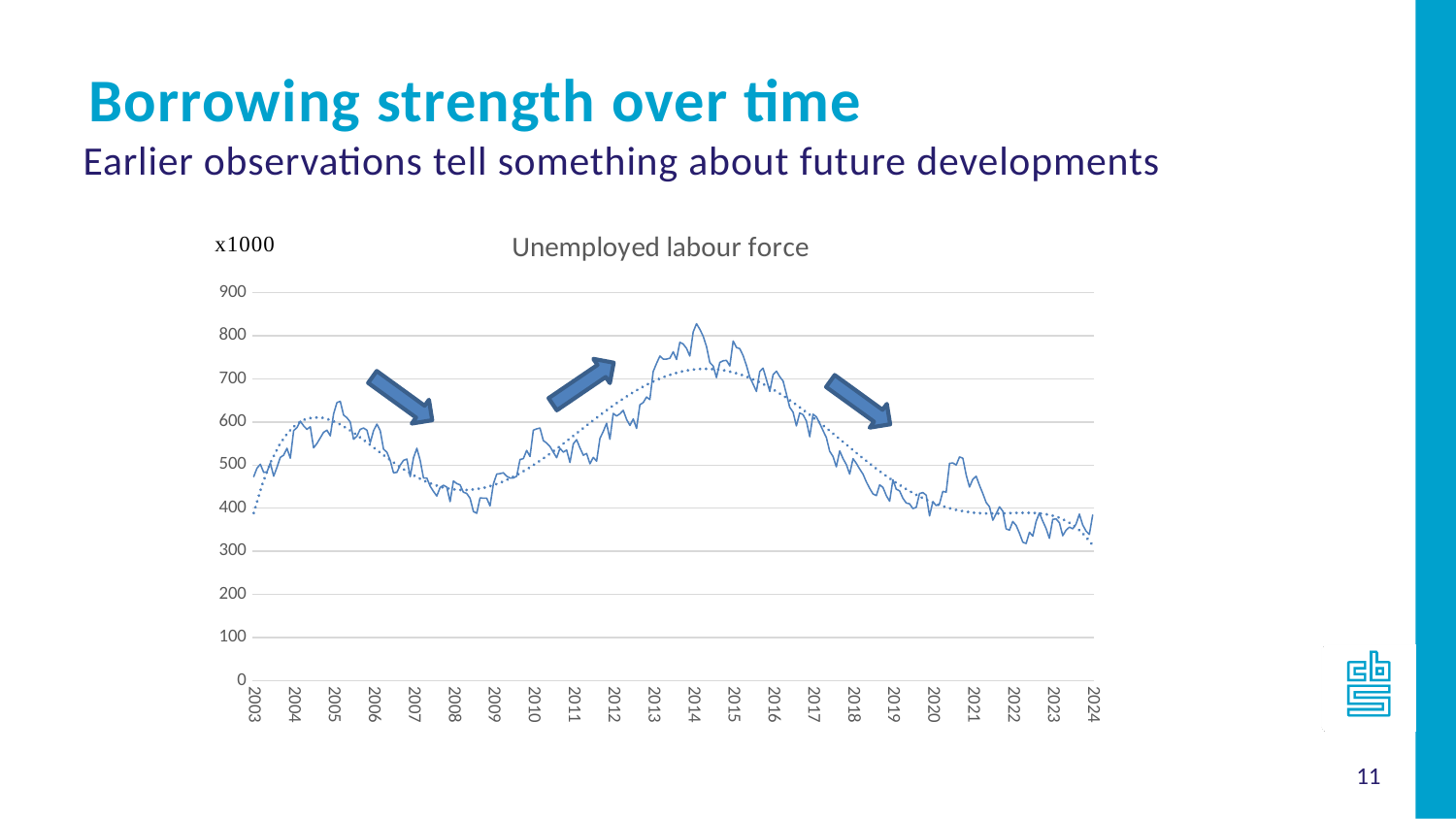
Is the peak value of the line around 2014 greater or less than 700? greater Is the value of the line at the start of 2017 greater or less than 500? greater What is the title of the chart? Unemployed labour force Does the line rise or fall between 2014 and 2022? fall How many year labels are shown on the x axis of the chart? 22 Is the value of the line in 2022 greater or less than 400? less Does the line rise or fall between 2009 and 2014? rise In which year does the unemployed labour force line reach its highest point? 2014 Which is higher, the value of the line in 2014 or in 2020? 2014 What kind of chart is shown on the slide? line chart What unit label is shown above the vertical axis of the chart? x1000